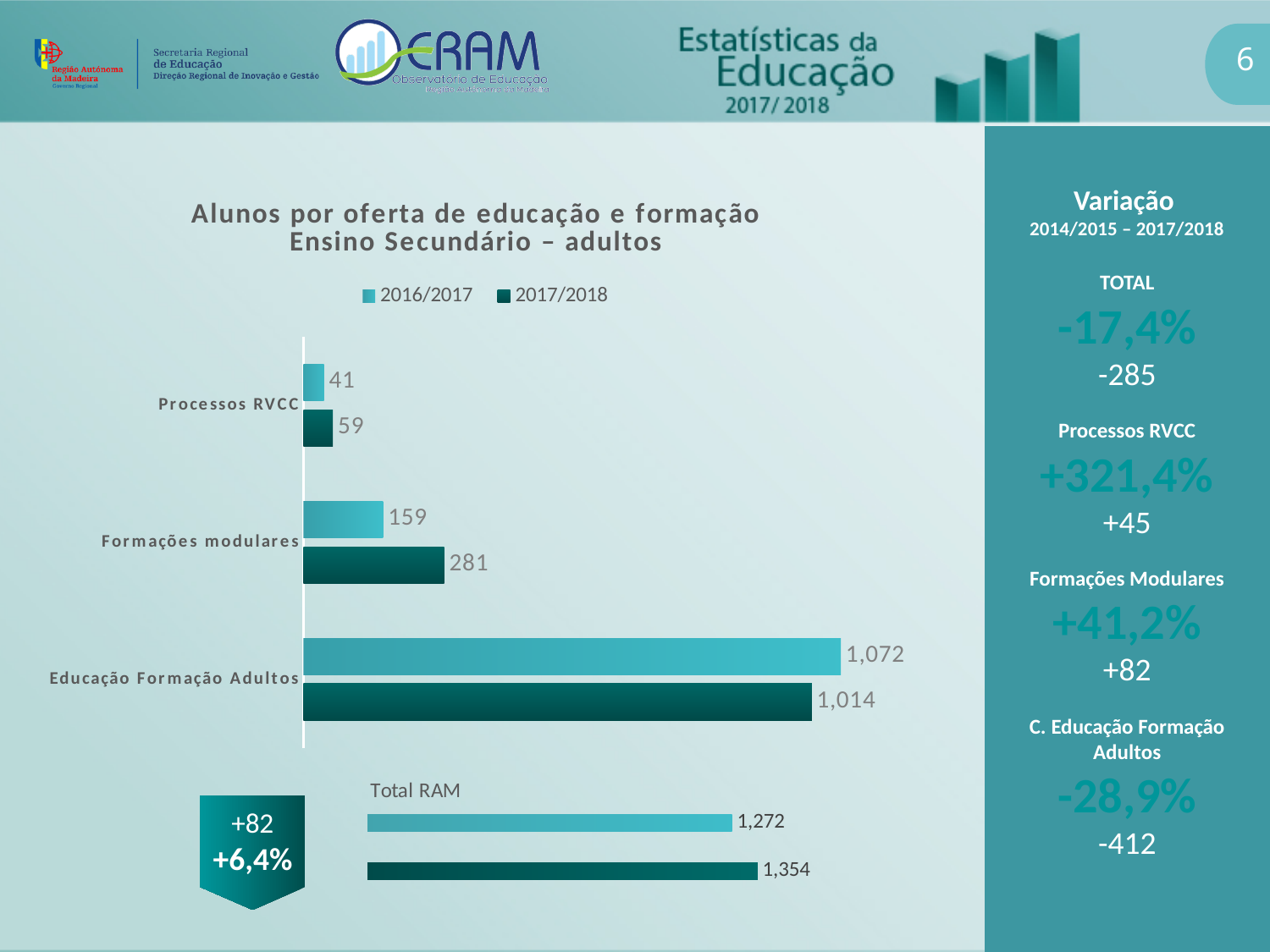
In the 'Total RAM' chart at the bottom of the slide, what is the value for 2017/2018? 1,354 In the 'Total RAM' chart at the bottom of the slide, what is the difference between the 2017/2018 and 2016/2017 values? 82 How many categories are shown in the chart 'Alunos por oferta de educação e formação Ensino Secundário – adultos'? 3 In the chart 'Alunos por oferta de educação e formação Ensino Secundário – adultos', what is the value for Educação Formação Adultos in 2017/2018? 1,014 How many series does the legend of the chart 'Alunos por oferta de educação e formação Ensino Secundário – adultos' list? 2 In the chart 'Alunos por oferta de educação e formação Ensino Secundário – adultos', which category has the highest value in 2016/2017? Educação Formação Adultos In the chart 'Alunos por oferta de educação e formação Ensino Secundário – adultos', is the 2016/2017 value for Educação Formação Adultos larger or smaller than the 2017/2018 value? larger In the chart 'Alunos por oferta de educação e formação Ensino Secundário – adultos', what is the value for Processos RVCC in 2017/2018? 59 In the chart 'Alunos por oferta de educação e formação Ensino Secundário – adultos', what is the difference between the 2017/2018 and 2016/2017 values for Formações modulares? 122 What kind of chart is 'Alunos por oferta de educação e formação Ensino Secundário – adultos'? bar chart In the chart 'Alunos por oferta de educação e formação Ensino Secundário – adultos', what is the value for Formações modulares in 2016/2017? 159 In the chart 'Alunos por oferta de educação e formação Ensino Secundário – adultos', which category has the lowest value in 2017/2018? Processos RVCC